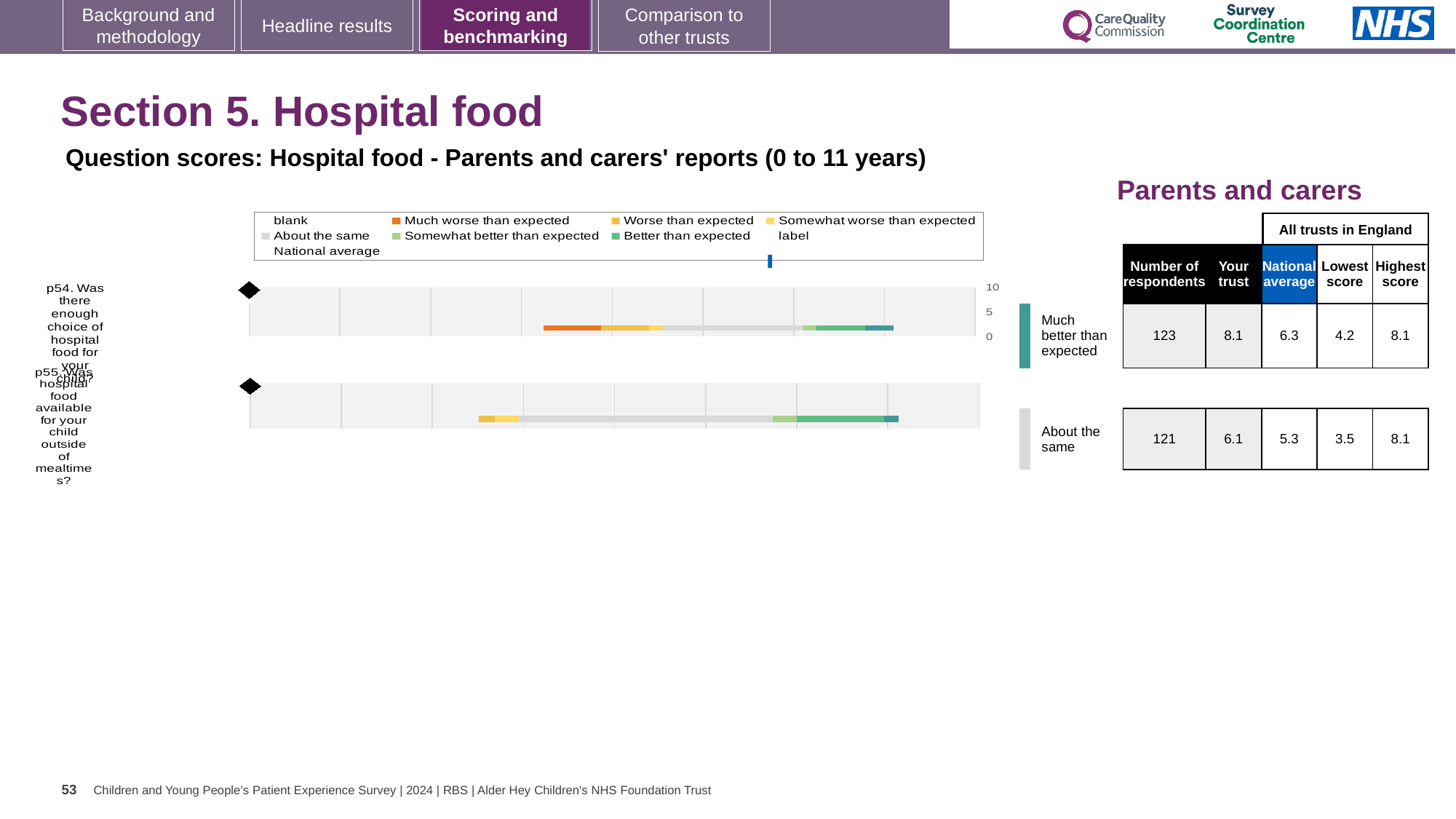
In the table beside the chart, what is the highest score for the row labelled 'Much better than expected'? 8.1 In the table beside the chart, what is the national average for the row labelled 'About the same'? 5.3 What kind of chart is shown on the slide? bar chart In the table beside the chart, which row has more respondents: 'Much better than expected' or 'About the same'? Much better than expected In the table beside the chart, what is the difference between 'Your trust' and 'National average' for the row labelled 'Much better than expected'? 1.8 In the table beside the chart, what is the 'Your trust' score for the row labelled 'Much better than expected'? 8.1 What is the heading above the chart? Question scores: Hospital food - Parents and carers' reports (0 to 11 years) In the table beside the chart, which is larger for the row labelled 'About the same': 'Your trust' or 'National average'? Your trust Which colour does the legend use for 'Much worse than expected'? orange In the table beside the chart, what is the lowest score for the row labelled 'About the same'? 3.5 In the table beside the chart, how many respondents are listed for the row labelled 'About the same'? 121 How many survey questions (bars) are plotted in the chart? 2